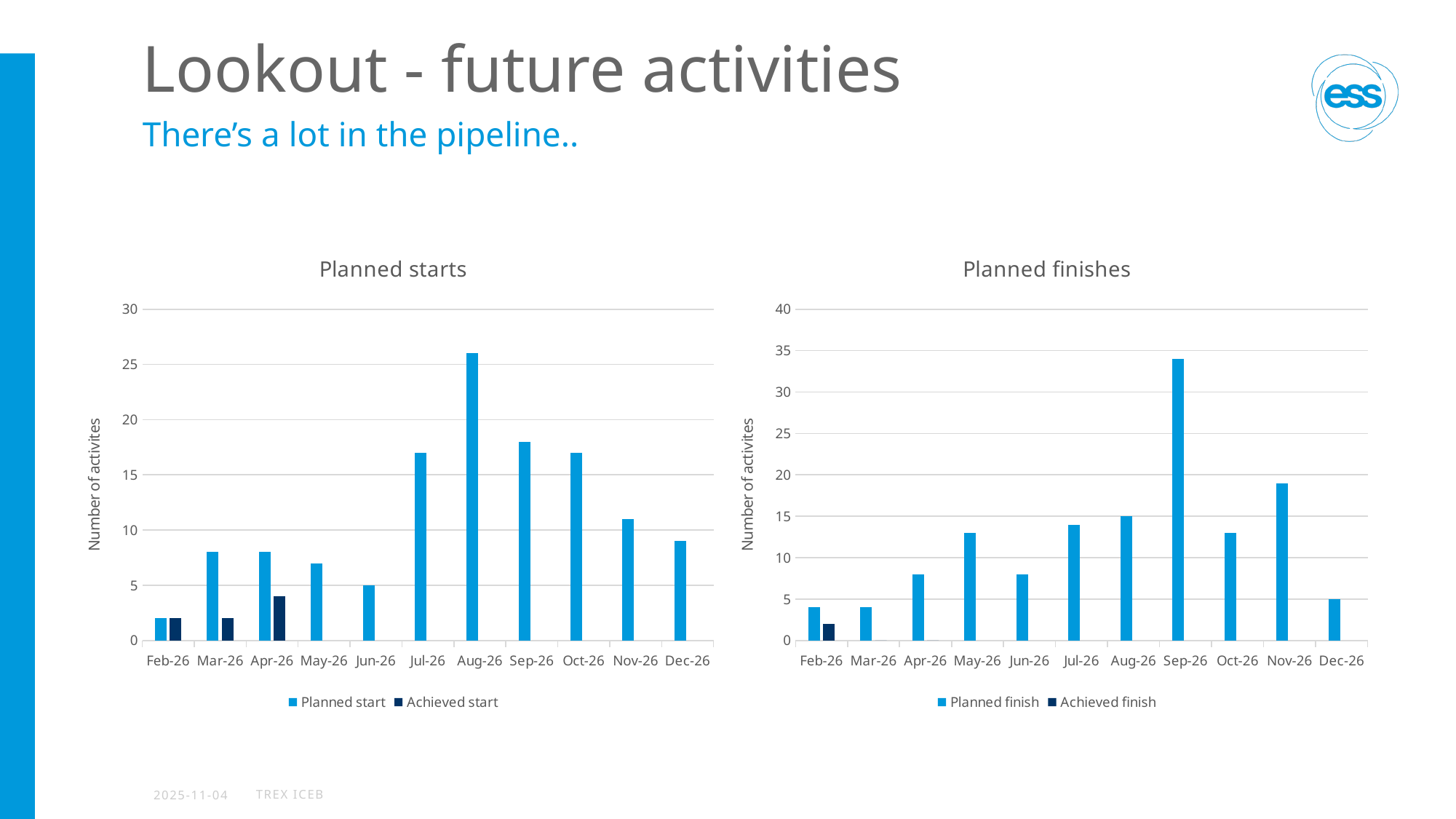
In the Planned finishes chart, is the Planned finish value for Sep-26 greater or less than 30? greater How many series does the legend of the Planned starts chart list? 2 In the Planned starts chart, which month has the highest Planned start value? Aug-26 What kind of chart is the Planned starts chart? bar chart In the Planned starts chart, is the Planned start value for Aug-26 greater or less than 25? greater In the Planned finishes chart, is the Planned finish value for Nov-26 greater or less than 20? less What is the y-axis title of the Planned finishes chart? Number of activities How many months are shown on the x axis of the Planned finishes chart? 11 In the Planned finishes chart, which month has the highest Planned finish value? Sep-26 In the Planned starts chart, which is larger, the Planned start value for Sep-26 or for Nov-26? Sep-26 In the Planned finishes chart, which is larger, the Planned finish value for Nov-26 or for Oct-26? Nov-26